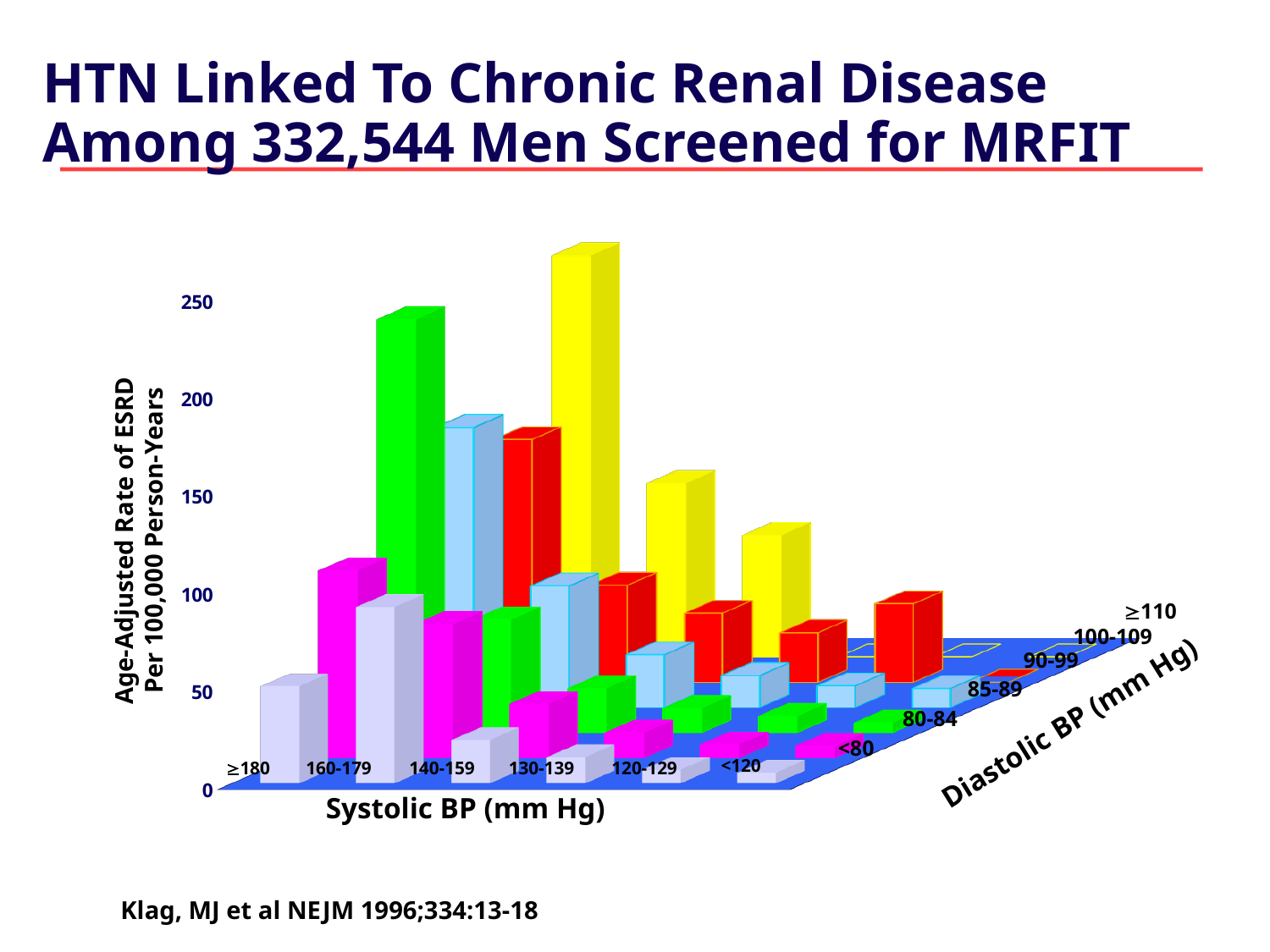
How many diastolic BP groups are plotted on the chart? 6 What is the label of the vertical axis? Age-Adjusted Rate of ESRD Per 100,000 Person-Years What is the label of the depth axis on the right side of the chart? Diastolic BP (mm Hg) Is the tallest green bar (85-89 diastolic group) greater or less than 200? greater Is the value for the <120 systolic bar in the <80 diastolic group greater or less than 50? less Do the bars in the ≥110 diastolic group rise or fall as systolic BP decreases from left to right? fall How many systolic BP categories are shown along the x axis? 6 What kind of chart is shown on the slide? bar chart Which is taller: the tallest yellow bar or the tallest red bar? the tallest yellow bar What is the highest tick value shown on the vertical axis? 250